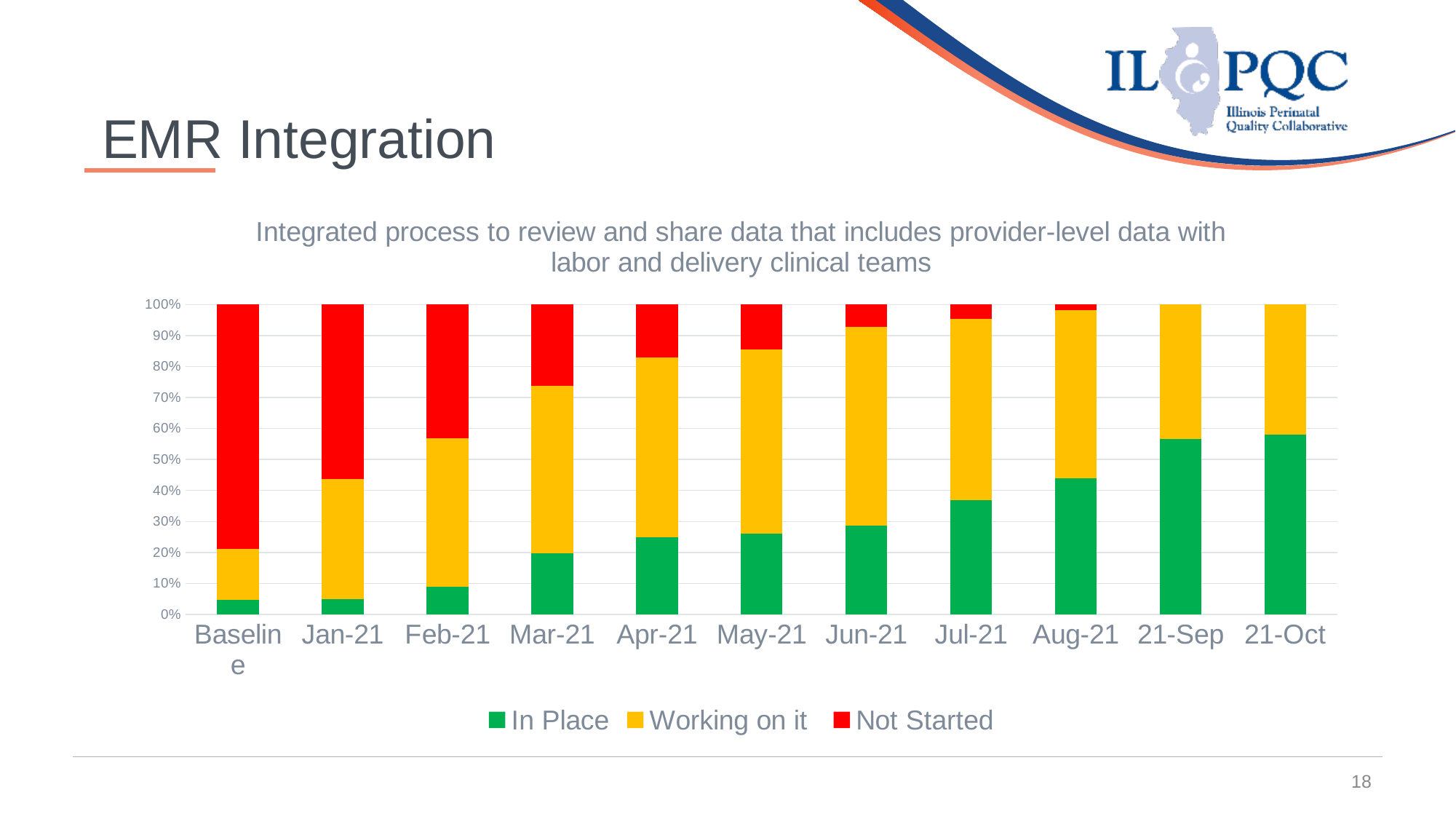
Which category has the largest Not Started share? Baseline What is the title of the chart? Integrated process to review and share data that includes provider-level data with labor and delivery clinical teams Is the In Place value for Jul-21 greater or less than 30%? greater Does the In Place share rise or fall from Baseline to 21-Oct? Rise Which series is shown in red in the chart? Not Started Is the Not Started value for Baseline greater or less than 70%? greater How many categories are shown along the x axis of the chart? 11 Which is larger, the In Place value for Jul-21 or for Apr-21? Jul-21 Which is larger, the Not Started value for Jan-21 or for Mar-21? Jan-21 Is the Not Started value for Jun-21 greater or less than 10%? less What kind of chart is shown on the slide? Stacked bar chart How many series does the chart's legend list? 3